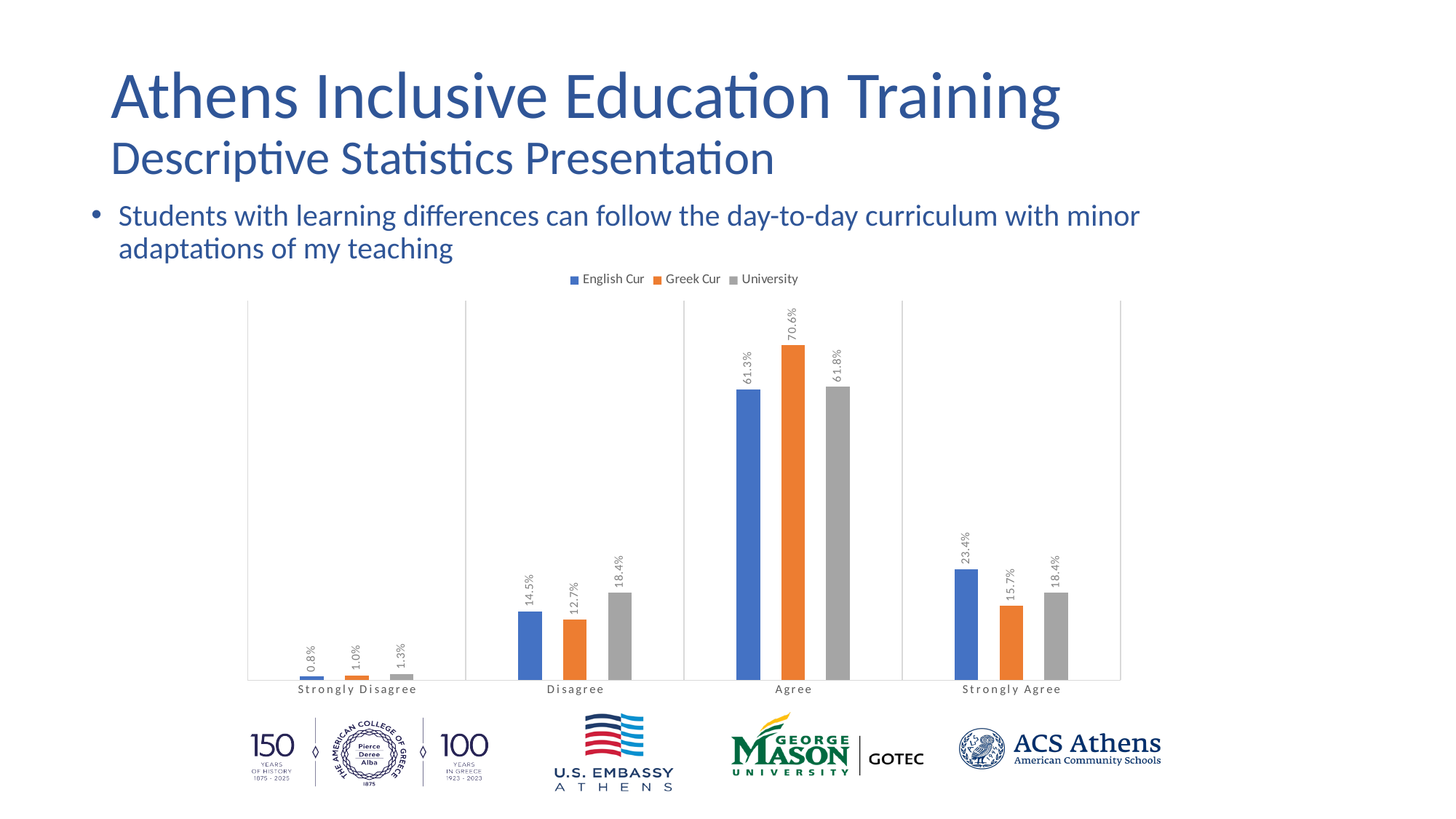
How many categories are shown on the x axis? 4 Which category has the lowest value for the University series? Strongly Disagree What kind of chart is shown on the slide? Bar chart What is the difference between the Greek Cur and English Cur values in the Agree category? 9.3% Which colour represents the University series in the chart? Grey Which category has the highest value for the Greek Cur series? Agree In the Strongly Agree category, which series has the larger value, English Cur or Greek Cur? English Cur How many series does the legend list? 3 What is the value for English Cur in the Strongly Agree category? 23.4% What is the value for University in the Disagree category? 18.4% What is the value for English Cur in the Strongly Disagree category? 0.8% What is the value for Greek Cur in the Agree category? 70.6%